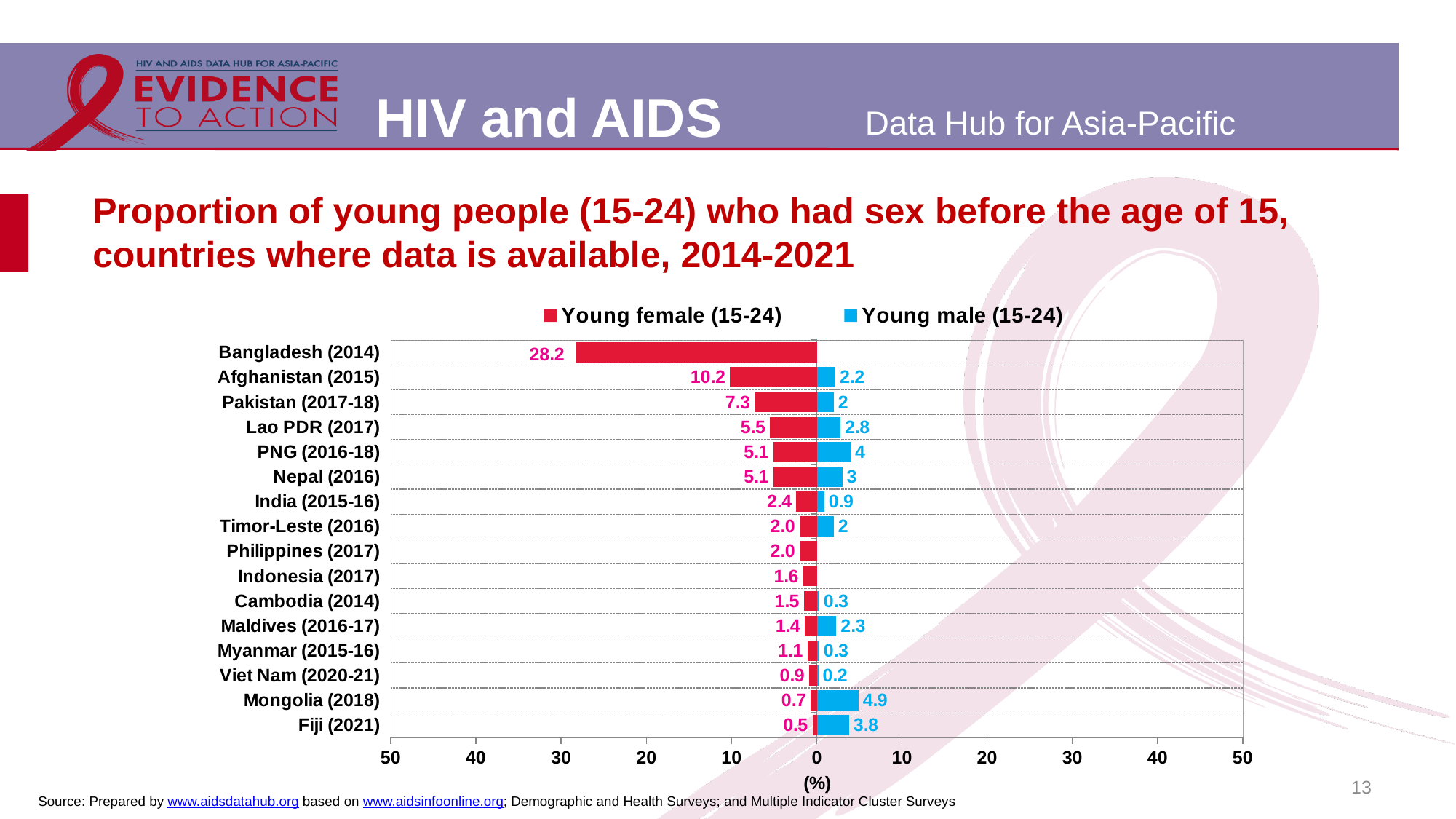
What is the value for Young female (15-24) in Bangladesh (2014)? 28.2 How many countries are shown on the chart? 16 Which country has the lowest value for Young female (15-24)? Fiji (2021) How many series does the legend list? 2 What is the difference between the Young female (15-24) and Young male (15-24) values for Afghanistan (2015)? 8 What is the value for Young female (15-24) in Afghanistan (2015)? 10.2 What kind of chart is shown on the slide? Bar chart What is the value for Young male (15-24) in Mongolia (2018)? 4.9 Which country has the highest value for Young male (15-24)? Mongolia (2018) Which country has the highest value for Young female (15-24)? Bangladesh (2014) Which is larger for Mongolia (2018): the Young female (15-24) value or the Young male (15-24) value? Young male (15-24) What is the value for Young male (15-24) in Fiji (2021)? 3.8